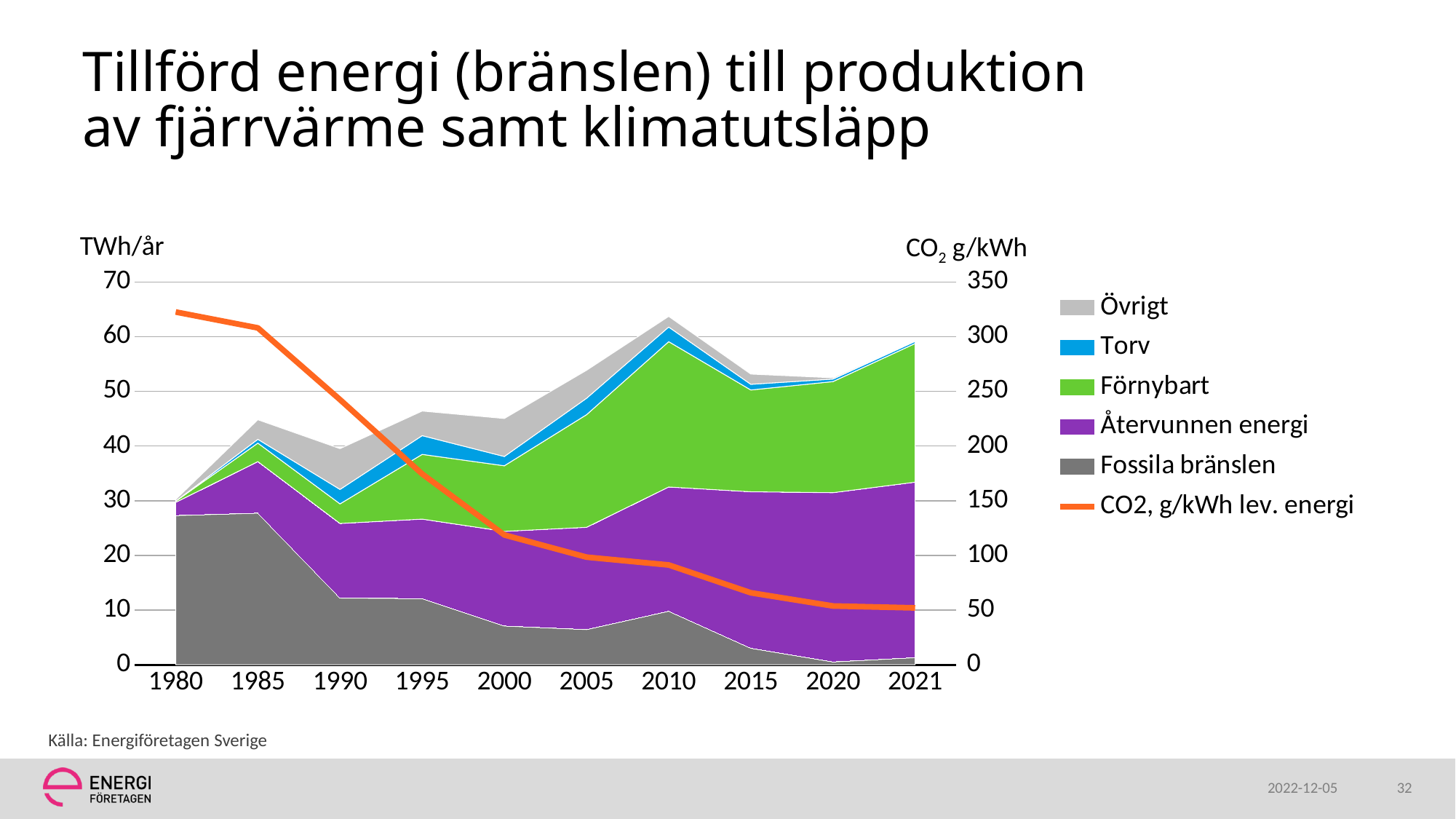
How many series does the legend list? 6 Is the CO2, g/kWh lev. energi value in 1980 greater or less than 300? greater Which series is shown in green in the legend? Förnybart What unit is shown on the left vertical axis? TWh/år Is the CO2, g/kWh lev. energi value larger in 1980 or in 2021? 1980 What kind of chart is shown on the slide? Stacked area chart with a line In which year is the CO2, g/kWh lev. energi value highest? 1980 How many years are labelled on the x axis? 10 Is the Fossila bränslen value in 2021 greater or less than 10 TWh/år? less Is the Fossila bränslen value in 1980 greater or less than 20 TWh/år? greater Does the CO2, g/kWh lev. energi line rise or fall from 1980 to 2021? Fall